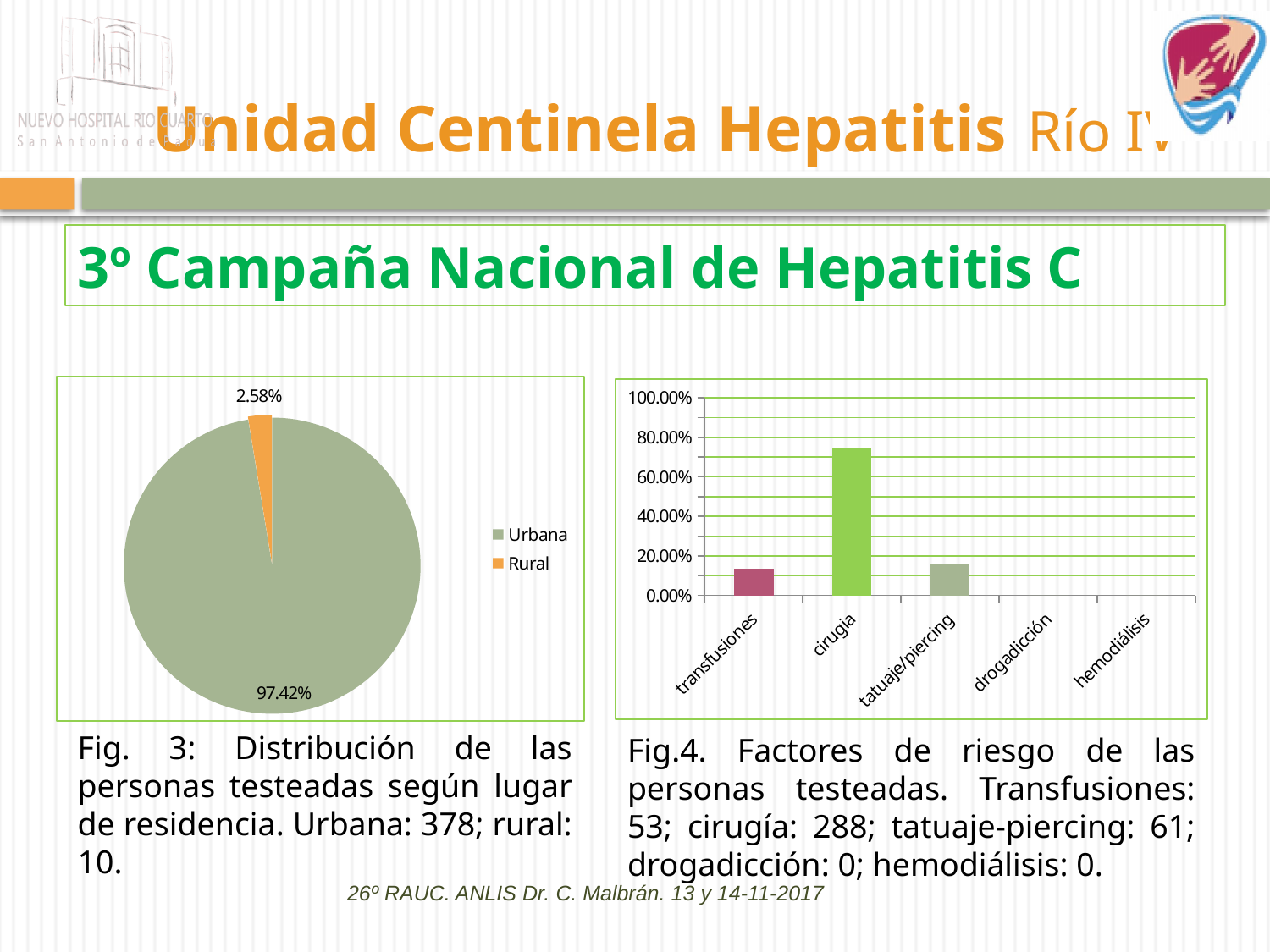
In the pie chart (Fig. 3), which slice is the largest? Urbana In the pie chart (Fig. 3), what percentage is shown for Urbana? 97.42% In the bar chart (Fig. 4), is the value for transfusiones greater or less than 20.00%? less In the pie chart (Fig. 3), how many entries does the legend list? 2 In the pie chart (Fig. 3), what is the difference in percentage points between the Urbana and Rural slices? 94.84 In the bar chart (Fig. 4), which category has the highest bar? cirugía In the bar chart (Fig. 4), how many categories are shown on the x axis? 5 In the bar chart (Fig. 4), which is larger, the bar for cirugía or the bar for tatuaje/piercing? cirugía What kind of chart is the one on the right (Fig. 4)? Bar chart In the bar chart (Fig. 4), is the value for cirugía greater or less than 60.00%? greater What kind of chart is the one on the left (Fig. 3)? Pie chart In the pie chart (Fig. 3), what percentage is shown for Rural? 2.58%